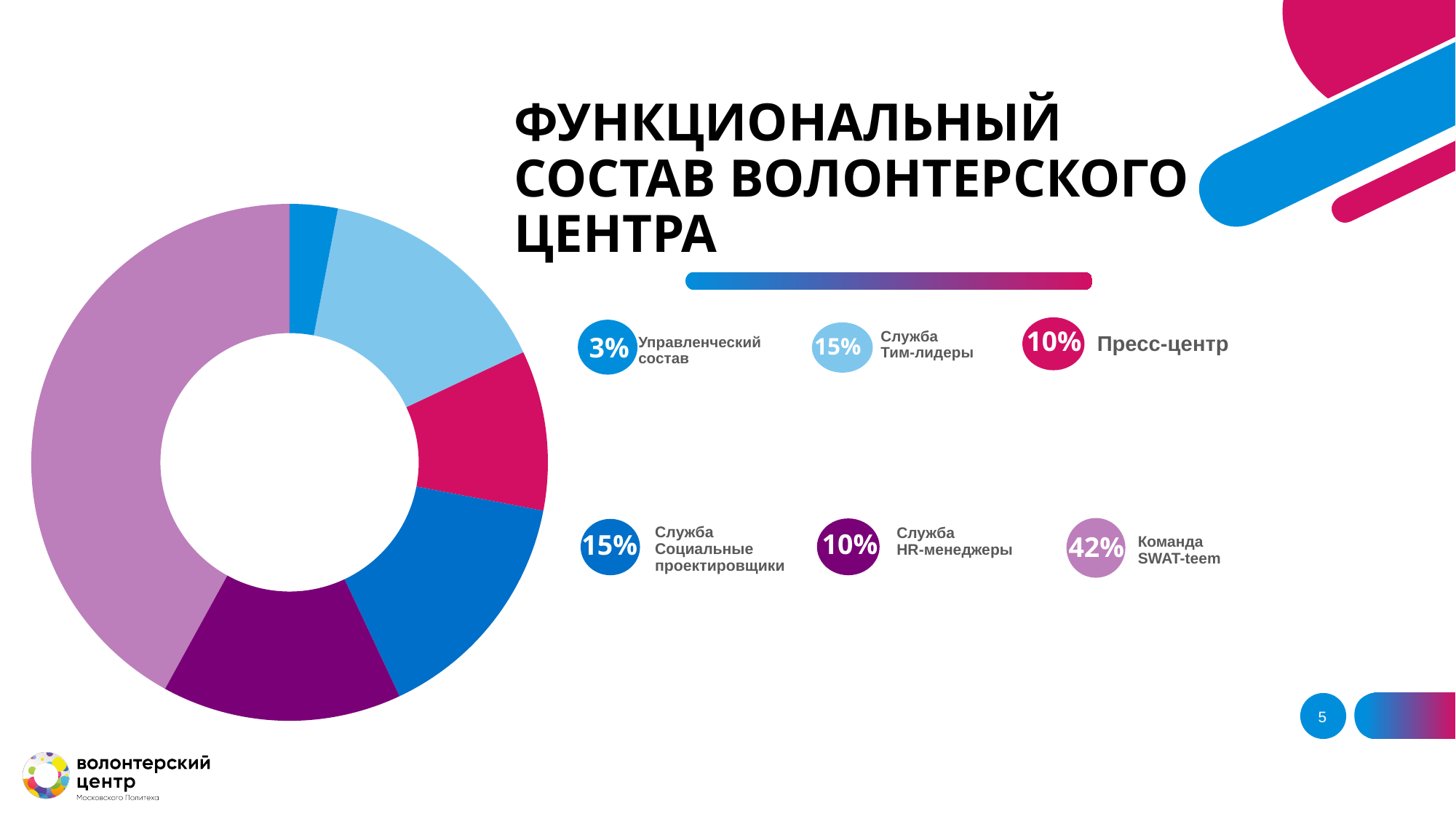
What share is Пресс-центр? 10% Which category has the smallest share of the chart? Управленческий состав How many categories does the chart show? 6 What kind of chart is shown on the slide? Donut (pie) chart Which is larger: the share of Служба Тим-лидеры or the share of Пресс-центр? Служба Тим-лидеры What share is Управленческий состав? 3% What share of the volunteer centre is Команда SWAT-teem? 42% Which category has the largest share of the chart? Команда SWAT-teem What is the difference between the share of Команда SWAT-teem and the share of Служба Социальные проектировщики? 27% What share is Служба HR-менеджеры? 10% What colour is the segment for Пресс-центр? Magenta (pink-red) What share is Служба Тим-лидеры? 15%